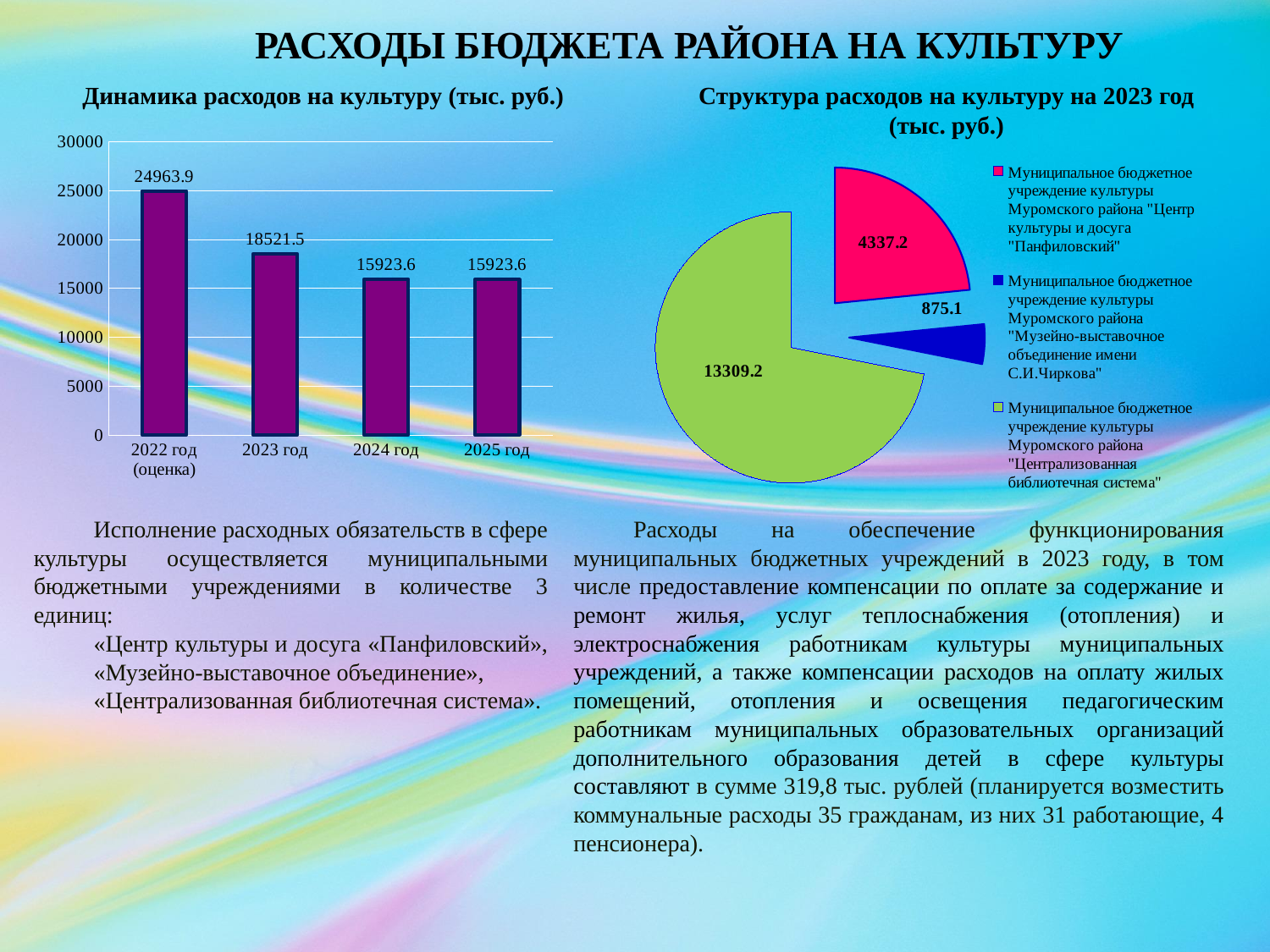
In the chart 'Динамика расходов на культуру (тыс. руб.)', what is the value for 2024 год? 15923.6 In the chart 'Динамика расходов на культуру (тыс. руб.)', which year has the highest value? 2022 год (оценка) In the pie chart 'Структура расходов на культуру на 2023 год (тыс. руб.)', what is the total of all three slices? 18521.5 In the pie chart 'Структура расходов на культуру на 2023 год (тыс. руб.)', what is the value for 'Централизованная библиотечная система'? 13309.2 In the pie chart 'Структура расходов на культуру на 2023 год (тыс. руб.)', how many entries does the legend list? 3 What kind of chart is 'Динамика расходов на культуру (тыс. руб.)'? bar chart In the chart 'Динамика расходов на культуру (тыс. руб.)', how many years are shown on the x axis? 4 In the chart 'Динамика расходов на культуру (тыс. руб.)', do the values rise or fall from 2022 to 2024? fall In the pie chart 'Структура расходов на культуру на 2023 год (тыс. руб.)', which institution has the smallest slice? Музейно-выставочное объединение имени С.И.Чиркова In the pie chart 'Структура расходов на культуру на 2023 год (тыс. руб.)', which is larger: the slice for 'Центр культуры и досуга "Панфиловский"' or the slice for 'Музейно-выставочное объединение имени С.И.Чиркова'? Центр культуры и досуга "Панфиловский" In the chart 'Динамика расходов на культуру (тыс. руб.)', what is the value for 2022 год (оценка)? 24963.9 In the chart 'Динамика расходов на культуру (тыс. руб.)', what is the difference between the values for 2022 год (оценка) and 2023 год? 6442.4